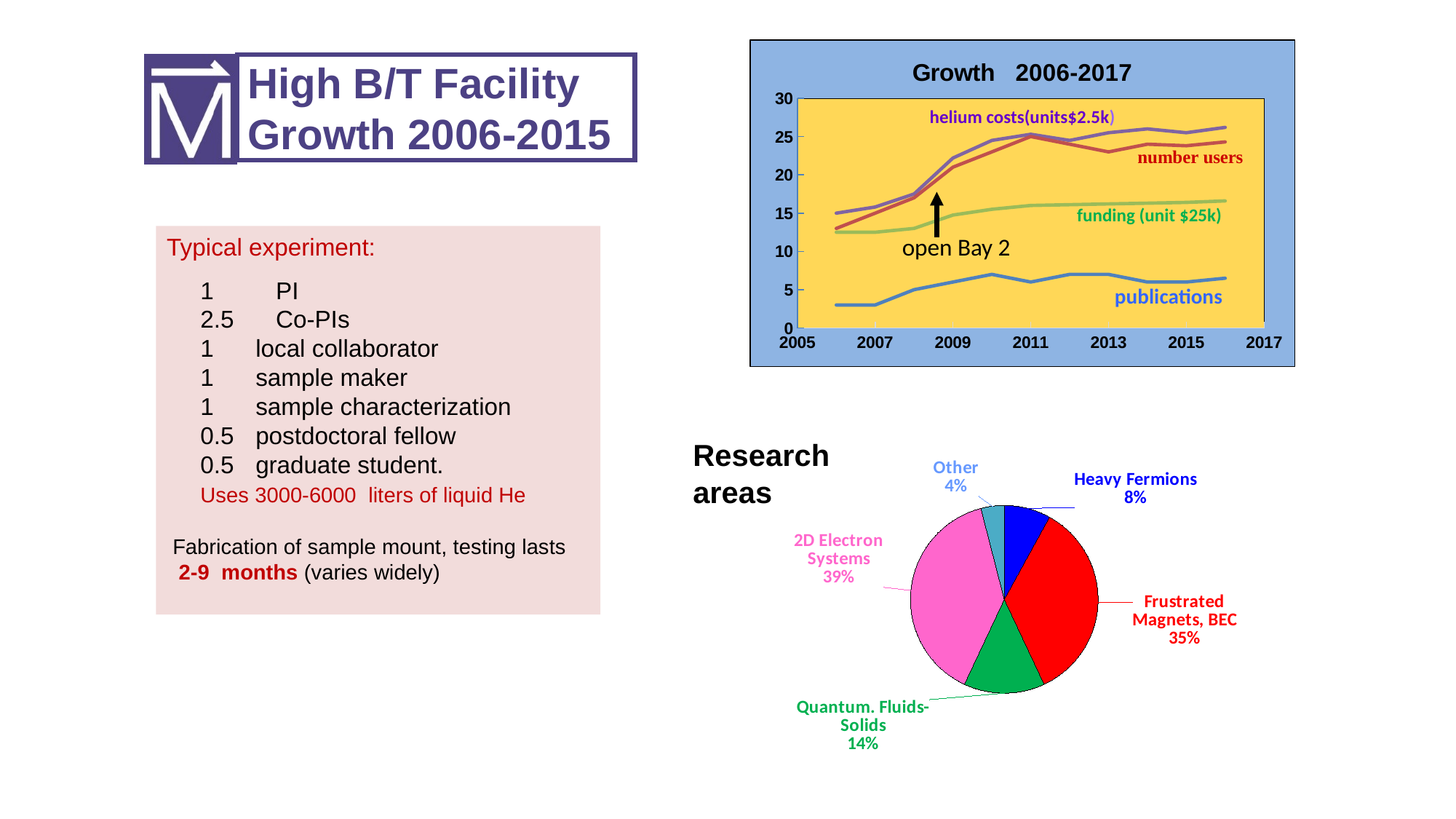
In the Research areas pie chart, which research area has the largest share? 2D Electron Systems In the Research areas pie chart, how many percentage points larger is 2D Electron Systems than Frustrated Magnets, BEC? 4 What kind of chart is the Growth 2006-2017 chart? Line chart In the Research areas pie chart, which research area has the smallest share? Other In the Research areas pie chart, what share is Quantum. Fluids-Solids? 14% In the Research areas pie chart, what share is Frustrated Magnets, BEC? 35% In the Research areas pie chart, which is larger: Heavy Fermions or Quantum. Fluids-Solids? Quantum. Fluids-Solids In the Research areas pie chart, how many slices are there? 5 In the Research areas pie chart, what share is 2D Electron Systems? 39% In the Growth 2006-2017 chart, is the value for publications in 2006 greater or less than 5? less In the Growth 2006-2017 chart, is the value for helium costs in 2016 greater or less than 25? greater In the Growth 2006-2017 chart, how many series are plotted? 4